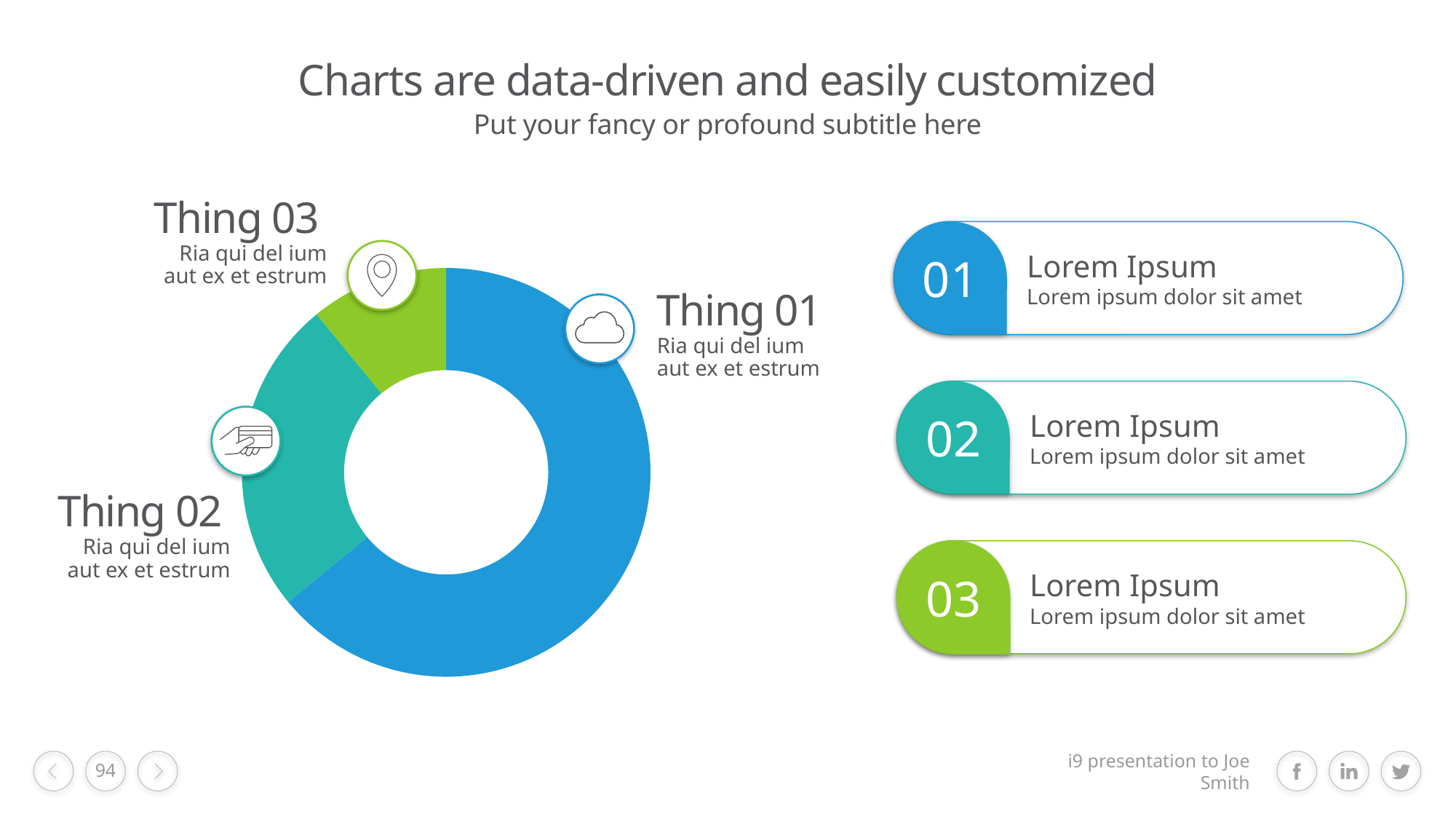
What kind of chart is shown on the slide? Donut chart What colour is the slice for Thing 02? Teal Which slice is larger, Thing 01 or Thing 02? Thing 01 Which slice is larger, Thing 02 or Thing 03? Thing 02 Which category has the smallest slice in the donut chart? Thing 03 Which category has the largest slice in the donut chart? Thing 01 Does Thing 01 take up more or less than half of the donut chart? More How many slices does the donut chart have? 3 What colour is the slice for Thing 03? Green